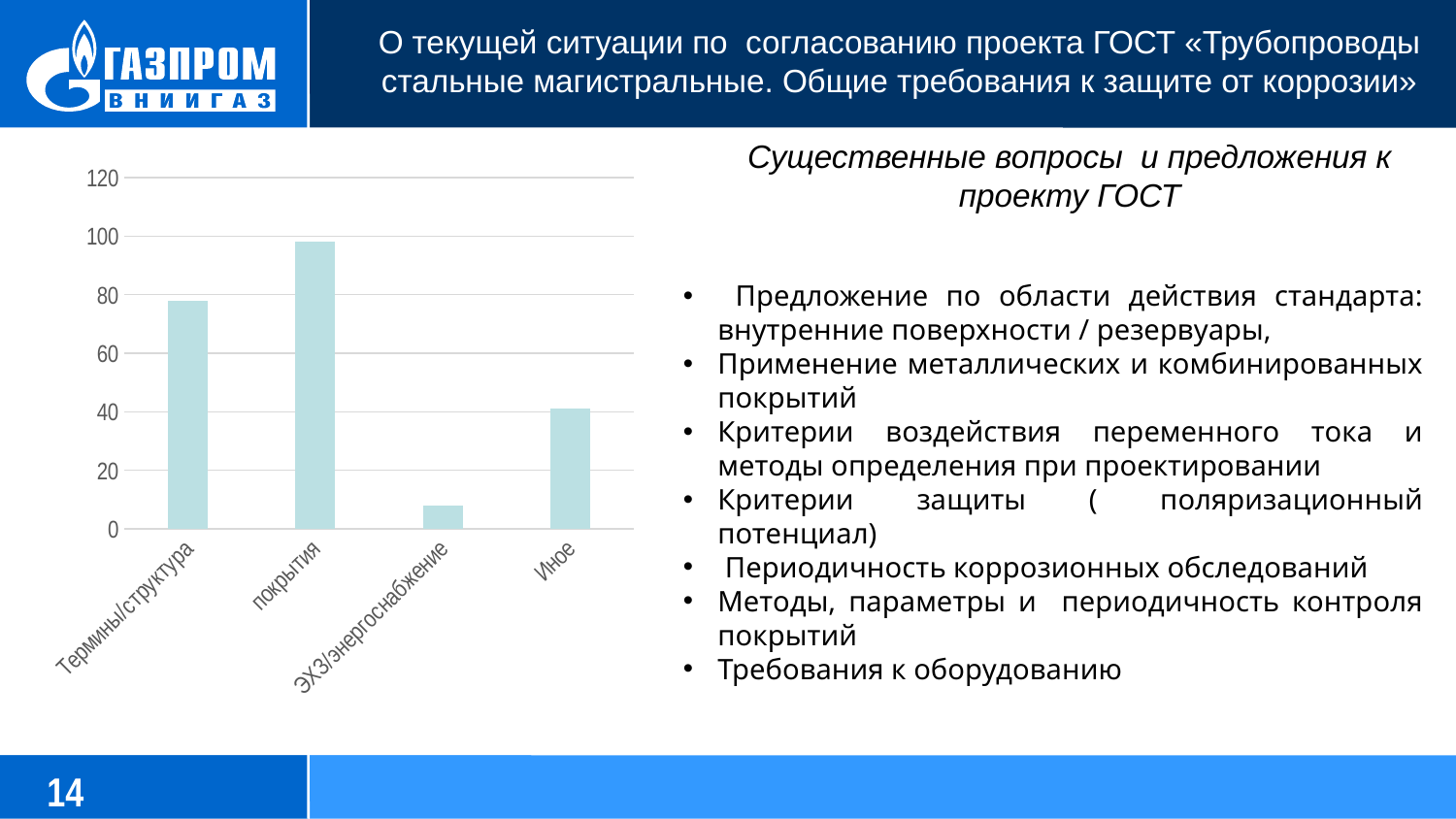
Is the value for ЭХЗ/энергоснабжение greater or less than 20? less What is the highest value shown on the vertical axis of the chart? 120 Is the value for Иное greater or less than 20? greater Is the value for покрытия greater or less than 80? greater What kind of chart is shown on the slide? bar chart Which is larger: the value for покрытия or the value for Термины/структура? покрытия Which category has the lowest bar in the chart? ЭХЗ/энергоснабжение Which is larger: the value for Термины/структура or the value for Иное? Термины/структура How many categories are shown on the x axis of the chart? 4 Which category has the highest bar in the chart? покрытия